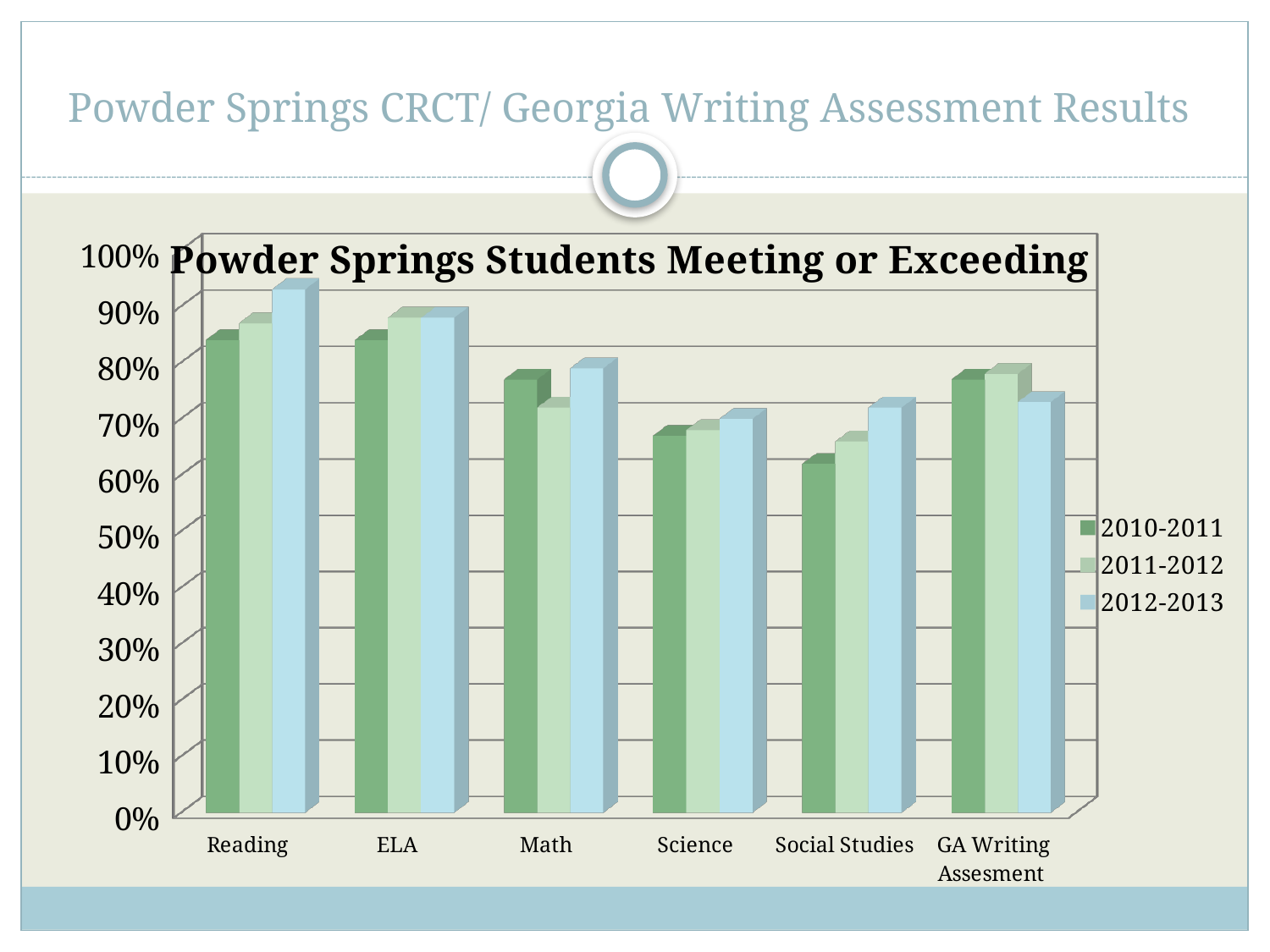
How many series does the chart's legend list? 3 Which school years are listed in the chart's legend? 2010-2011, 2011-2012, 2012-2013 Do the Social Studies values rise or fall from 2010-2011 to 2012-2013? rise Is the value for Social Studies in 2010-2011 greater or less than 70%? less Which subject has the highest value for 2012-2013? Reading What is the title of the chart? Powder Springs Students Meeting or Exceeding Which subject has the lowest value for 2010-2011? Social Studies For Math, which is larger: the 2011-2012 value or the 2012-2013 value? 2012-2013 How many subject categories are shown on the x axis of the chart? 6 Is the value for Science in 2010-2011 greater or less than 60%? greater Is the value for Reading in 2012-2013 greater or less than 90%? greater What kind of chart is shown on the slide? bar chart